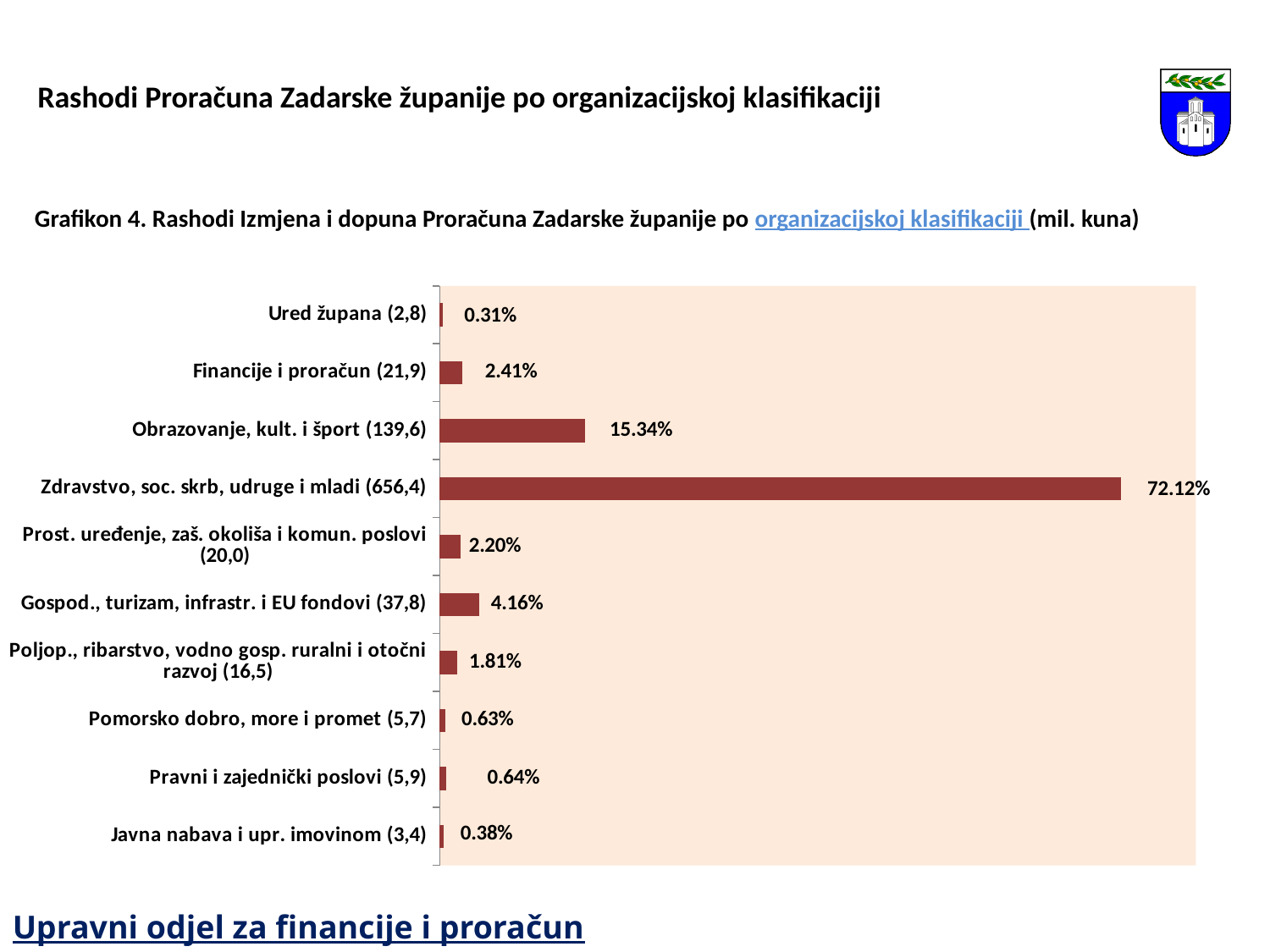
What is the value shown for Javna nabava i upr. imovinom? 0.38% Which is larger, the value for Financije i proračun or the value for Prost. uređenje, zaš. okoliša i komun. poslovi? Financije i proračun What is the difference between the values for Zdravstvo, soc. skrb, udruge i mladi and Obrazovanje, kult. i šport? 56.78% What is the value shown for Gospod., turizam, infrastr. i EU fondovi? 4.16% What is the value shown for Zdravstvo, soc. skrb, udruge i mladi? 72.12% Which category has the highest value in the chart? Zdravstvo, soc. skrb, udruge i mladi What is the value shown for Obrazovanje, kult. i šport? 15.34% What is the difference between the values for Gospod., turizam, infrastr. i EU fondovi and Financije i proračun? 1.75% Which category has the lowest value in the chart? Ured župana How many categories are plotted in the chart? 10 What kind of chart is shown on the slide? bar chart What unit is given in parentheses in the chart caption (Grafikon 4)? mil. kuna